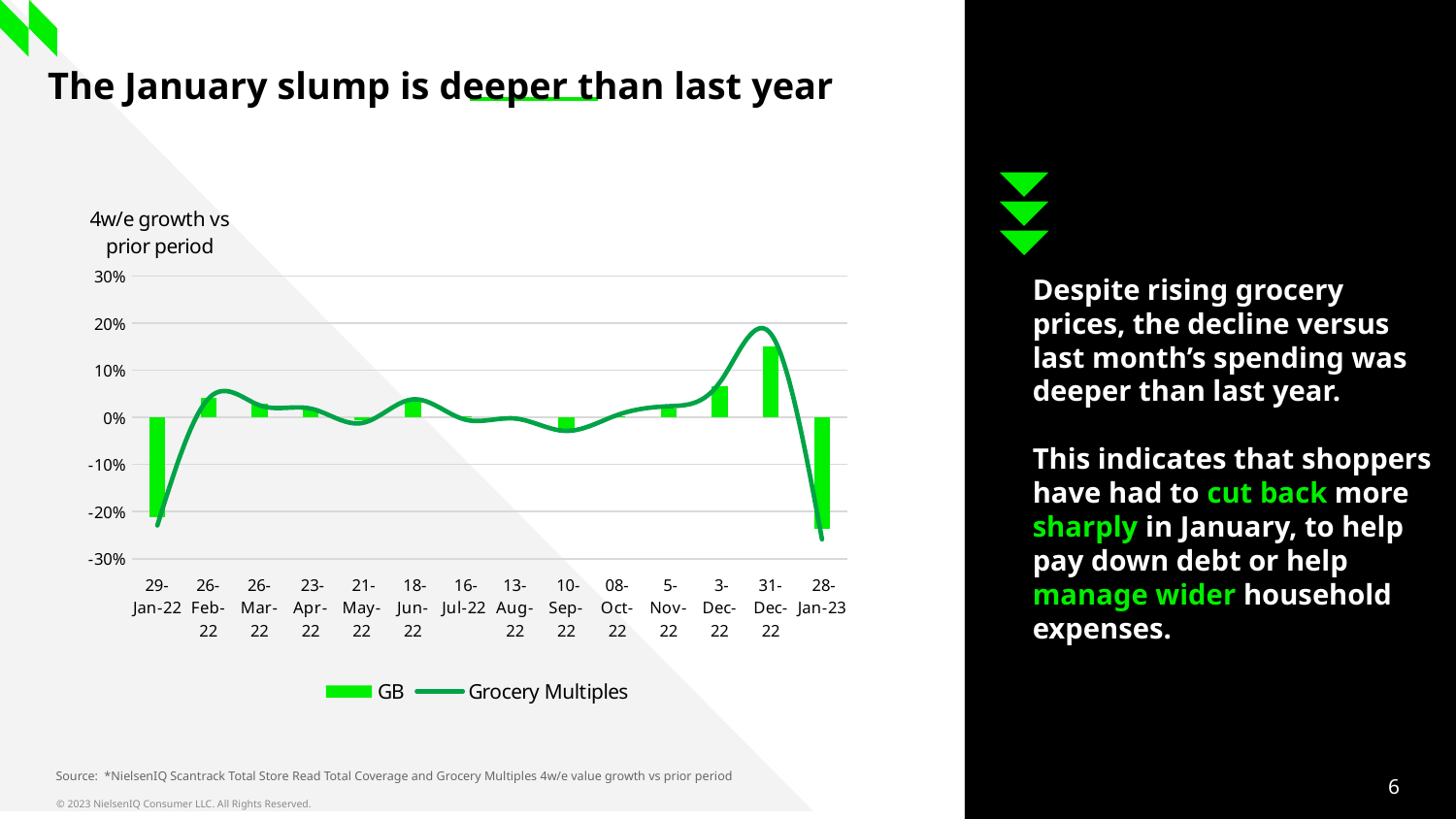
For which period is the GB bar the highest? 31-Dec-22 For which period is the GB bar the lowest? 28-Jan-23 Does the GB value rise or fall from 31-Dec-22 to 28-Jan-23? Fall Is the Grocery Multiples value for 31-Dec-22 greater or less than 10%? greater Which series is drawn as a line in the chart? Grocery Multiples Is the GB value for 28-Jan-23 greater or less than -10%? less What are the two series named in the chart legend? GB and Grocery Multiples Is the GB value for 31-Dec-22 greater or less than 10%? greater What kind of chart is shown on the slide? A combined bar and line chart Which is larger, the GB value for 31-Dec-22 or the GB value for 3-Dec-22? 31-Dec-22 How many dated periods are shown along the x axis of the chart? 14 How many series does the chart legend list? 2